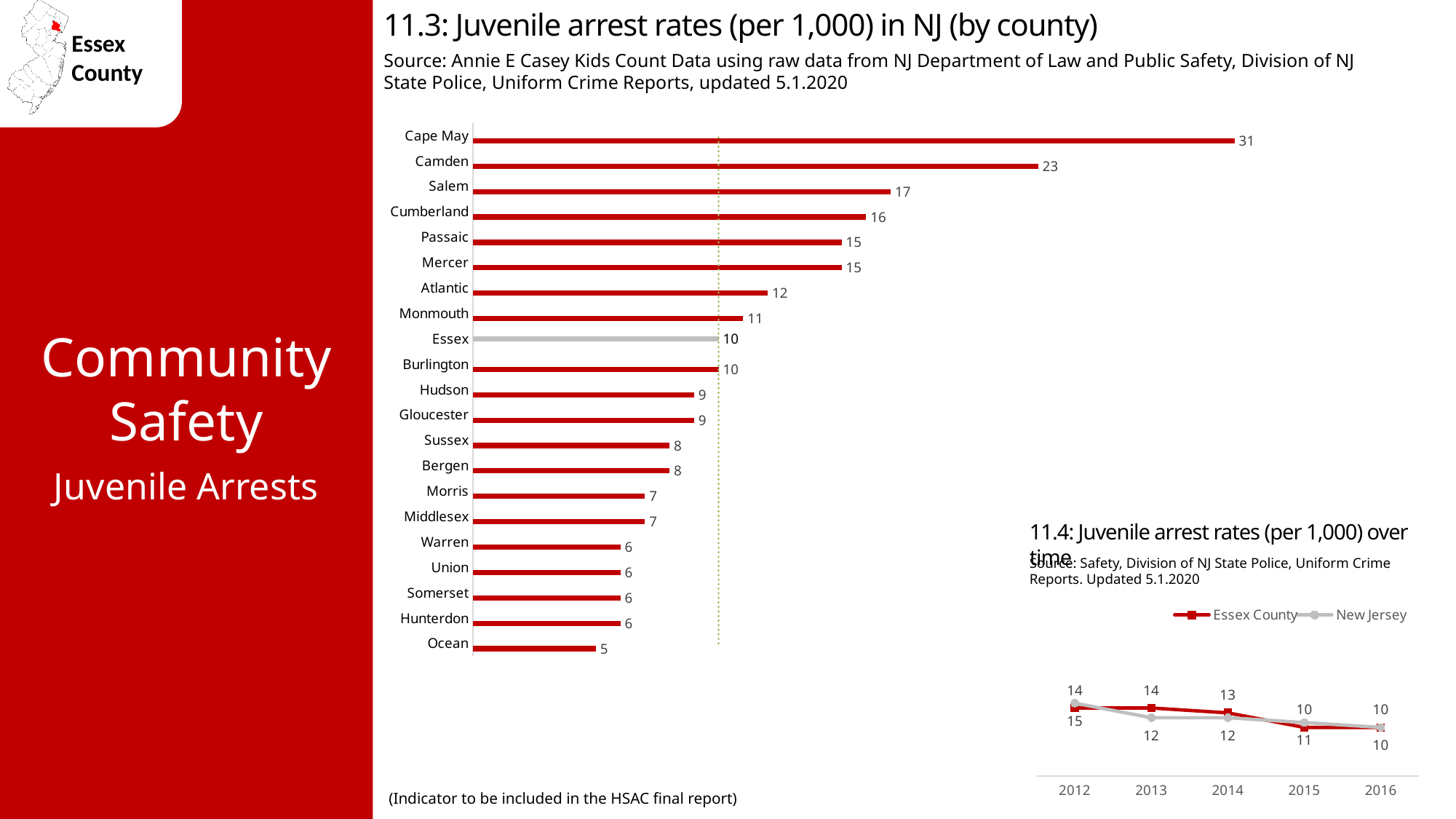
In the chart '11.4: Juvenile arrest rates (per 1,000) over time', does the Essex County rate rise or fall from 2013 to 2016? Fall What kind of chart is '11.3: Juvenile arrest rates (per 1,000) in NJ (by county)'? Bar chart In the chart '11.4: Juvenile arrest rates (per 1,000) over time', what is the value for Essex County in 2013? 14 In the chart '11.3: Juvenile arrest rates (per 1,000) in NJ (by county)', which has a higher value, Salem or Atlantic? Salem In the chart '11.4: Juvenile arrest rates (per 1,000) over time', how many series does the legend list? 2 In the chart '11.3: Juvenile arrest rates (per 1,000) in NJ (by county)', which bar is coloured gray instead of red? Essex In the chart '11.3: Juvenile arrest rates (per 1,000) in NJ (by county)', what is the value for Essex? 10 In the chart '11.3: Juvenile arrest rates (per 1,000) in NJ (by county)', which county has the lowest juvenile arrest rate? Ocean In the chart '11.3: Juvenile arrest rates (per 1,000) in NJ (by county)', what is the value for Cumberland? 16 In the chart '11.3: Juvenile arrest rates (per 1,000) in NJ (by county)', how many counties are shown? 21 In the chart '11.3: Juvenile arrest rates (per 1,000) in NJ (by county)', what is the difference between the values for Cape May and Camden? 8 In the chart '11.3: Juvenile arrest rates (per 1,000) in NJ (by county)', which county has the highest juvenile arrest rate? Cape May